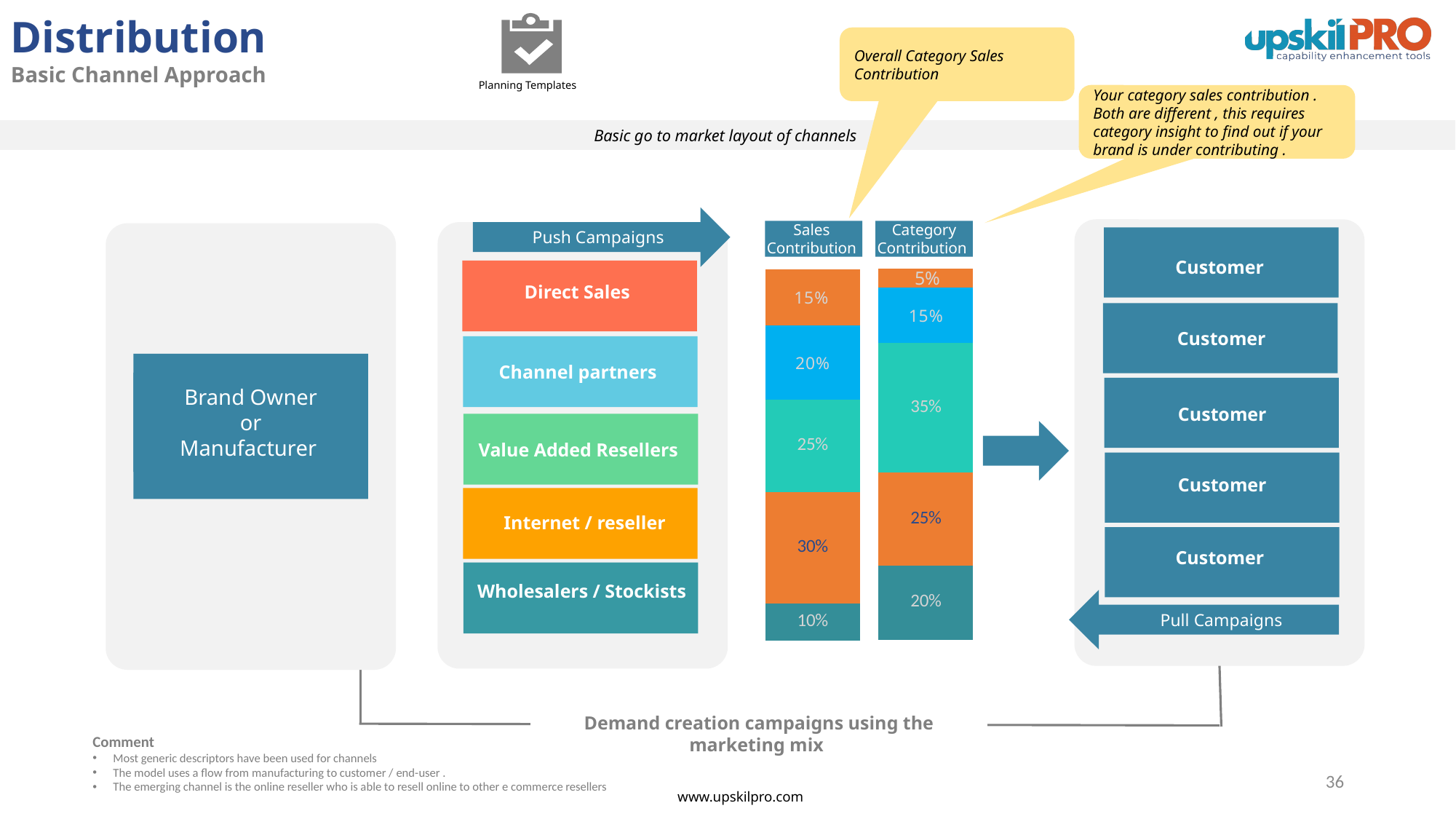
What is the value of the largest segment in the Sales Contribution bar? 30% What is the value of the smallest segment in the Category Contribution bar? 5% What is the difference between the top segment of the Sales Contribution bar (15%) and the top segment of the Category Contribution bar (5%)? 10% What are the titles of the two stacked bars on the slide? Sales Contribution and Category Contribution Which bar has the larger bottom segment, Sales Contribution or Category Contribution? Category Contribution How many segments does the Sales Contribution stacked bar have? 5 What is the value of the top segment of the Sales Contribution stacked bar? 15% What kind of chart is used to show Sales Contribution and Category Contribution? Stacked bar chart What is the value of the bottom segment of the Category Contribution stacked bar? 20% What is the total of all segments in the Sales Contribution bar? 100% What is the value of the third segment from the top in the Sales Contribution bar? 25% What is the value of the largest segment in the Category Contribution bar? 35%